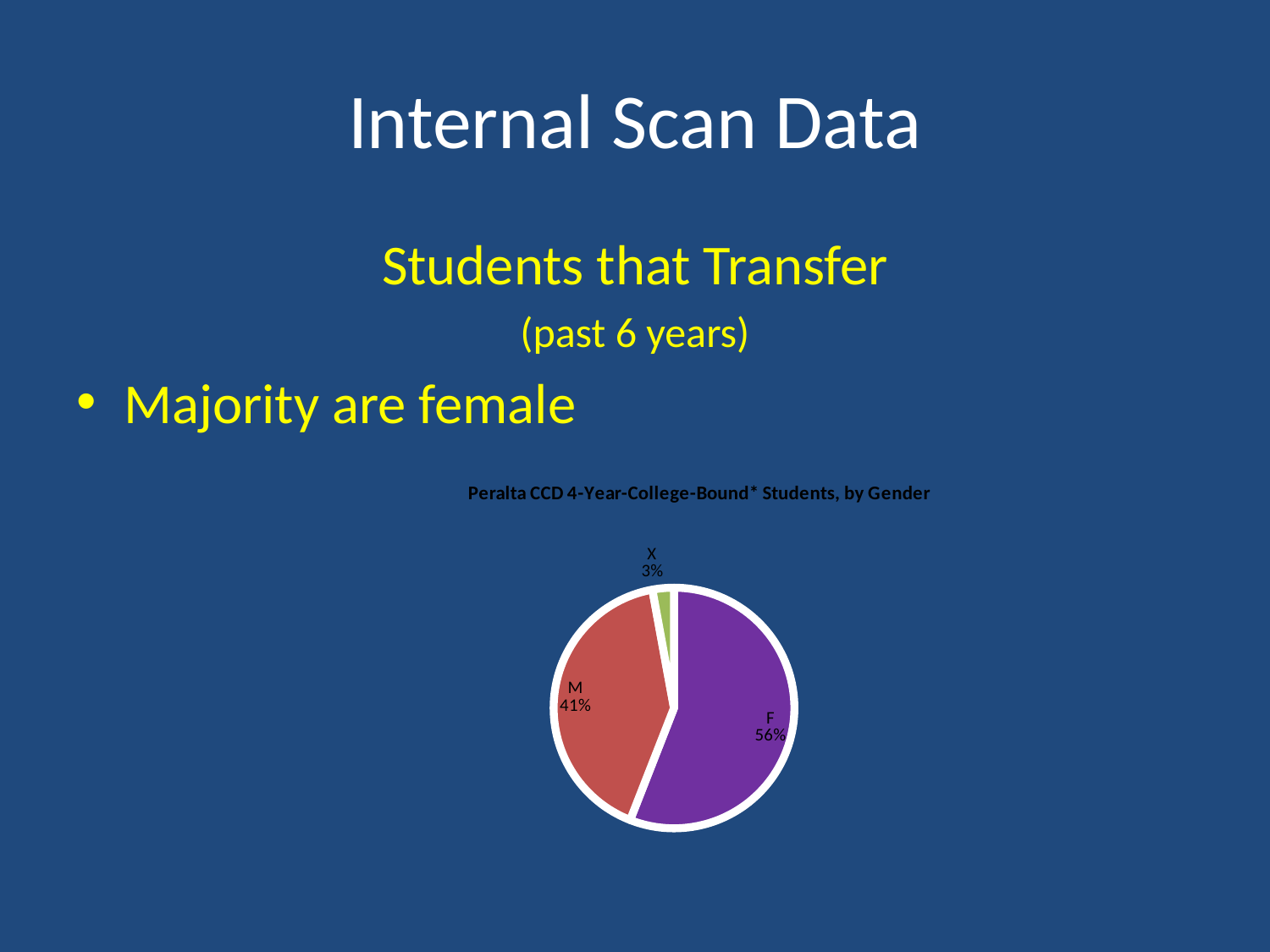
Which category has the smallest slice of the pie? X What share of the pie is labelled F? 56% Which slice is larger, M or X? M How many slices does the pie chart have? 3 What colour is the slice labelled F? purple What is the difference in percentage points between the M and X slices? 38 What is the difference in percentage points between the F and M slices? 15 What kind of chart is shown on the slide? pie chart What share of the pie is labelled M? 41% Which category has the largest slice of the pie? F What share of the pie is labelled X? 3% What is the title of the chart? Peralta CCD 4-Year-College-Bound* Students, by Gender